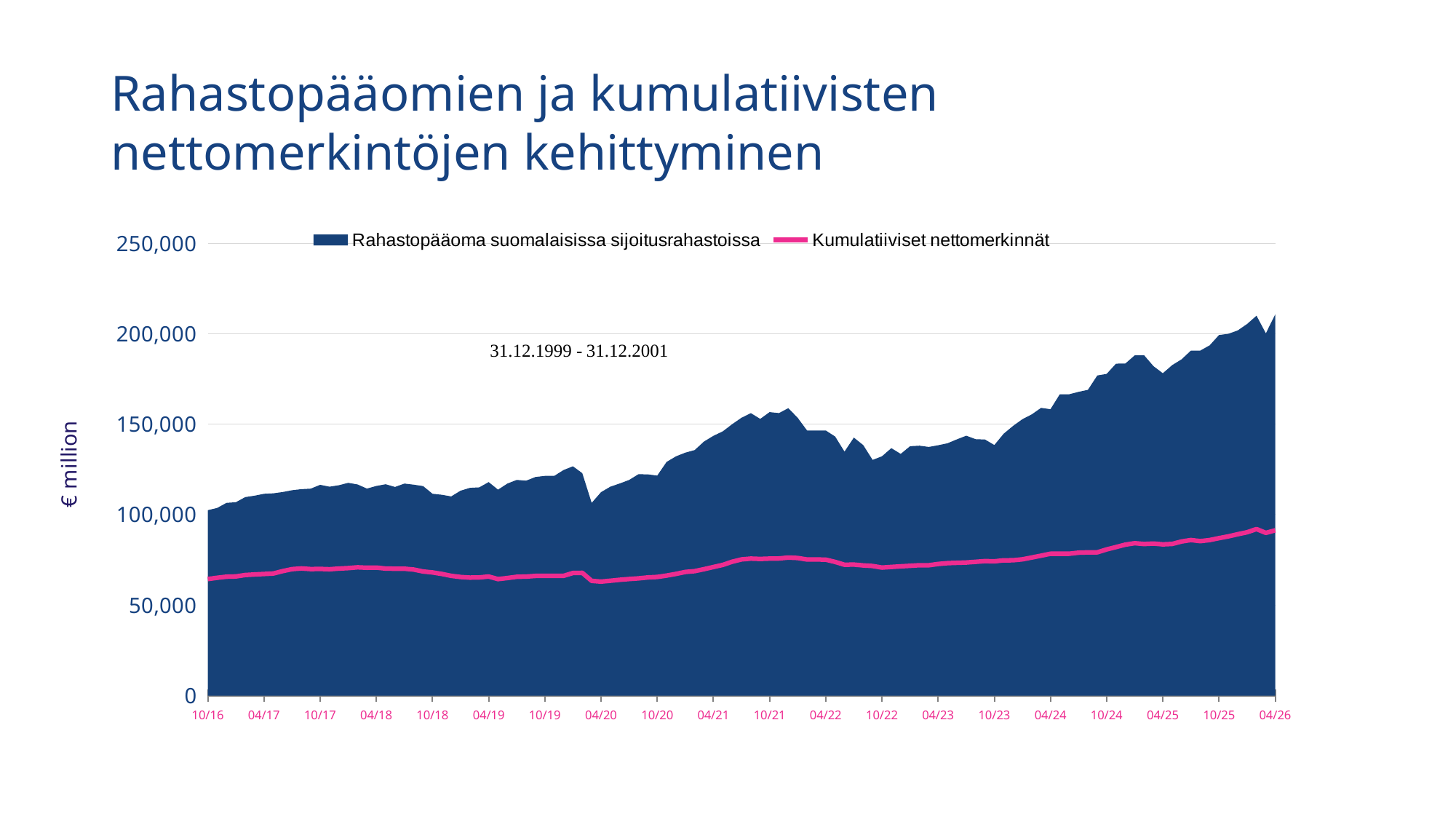
Does Rahastopääoma suomalaisissa sijoitusrahastoissa overall rise or fall from 10/16 to 04/26? rise Is the value of Rahastopääoma suomalaisissa sijoitusrahastoissa at 10/21 greater or less than 150,000? greater Is the value of Rahastopääoma suomalaisissa sijoitusrahastoissa at 10/22 greater or less than 150,000? less Is the value of Kumulatiiviset nettomerkinnät at 10/16 greater or less than 50,000? greater What unit is shown on the y-axis label? € million How many date labels are shown on the x-axis? 20 What kind of chart is shown on the slide? Area chart with a line series What are the two series named in the legend? Rahastopääoma suomalaisissa sijoitusrahastoissa; Kumulatiiviset nettomerkinnät Which series has the larger value at 04/26, Rahastopääoma suomalaisissa sijoitusrahastoissa or Kumulatiiviset nettomerkinnät? Rahastopääoma suomalaisissa sijoitusrahastoissa How many series does the legend list? 2